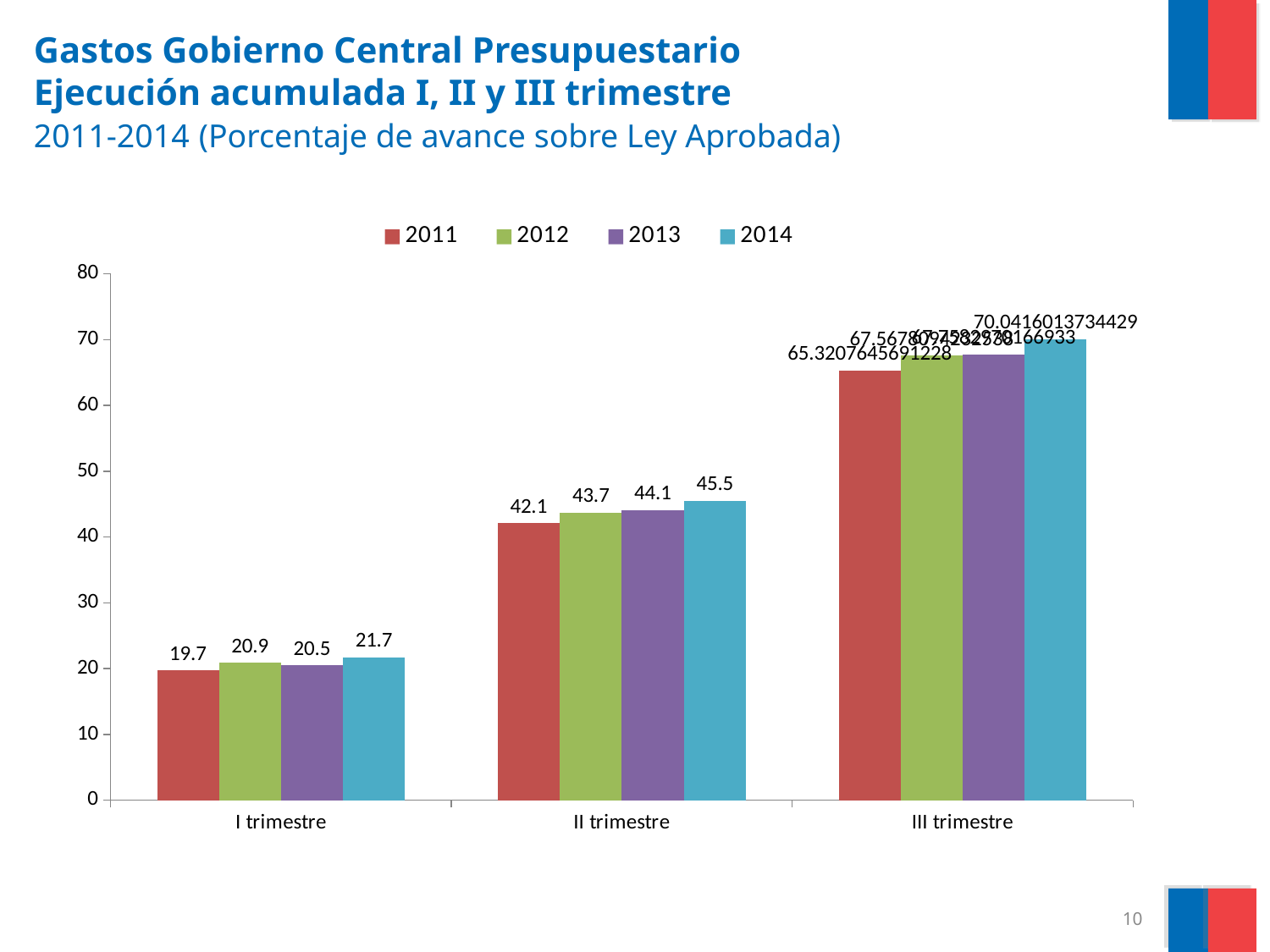
Which year has the highest value in I trimestre? 2014 What is the value for 2011 in I trimestre? 19.7 Do the values for 2014 rise or fall from I trimestre to III trimestre? Rise Is the value for 2011 in III trimestre greater or less than 60? greater What is the difference between the 2014 and 2011 values in II trimestre? 3.4 What kind of chart is shown on the slide? Bar chart In I trimestre, which is larger: the value for 2012 or the value for 2013? 2012 Which year has the lowest value in II trimestre? 2011 How many series does the legend list? 4 What is the value for 2013 in II trimestre? 44.1 How many categories are shown on the x axis? 3 What is the value for 2014 in II trimestre? 45.5